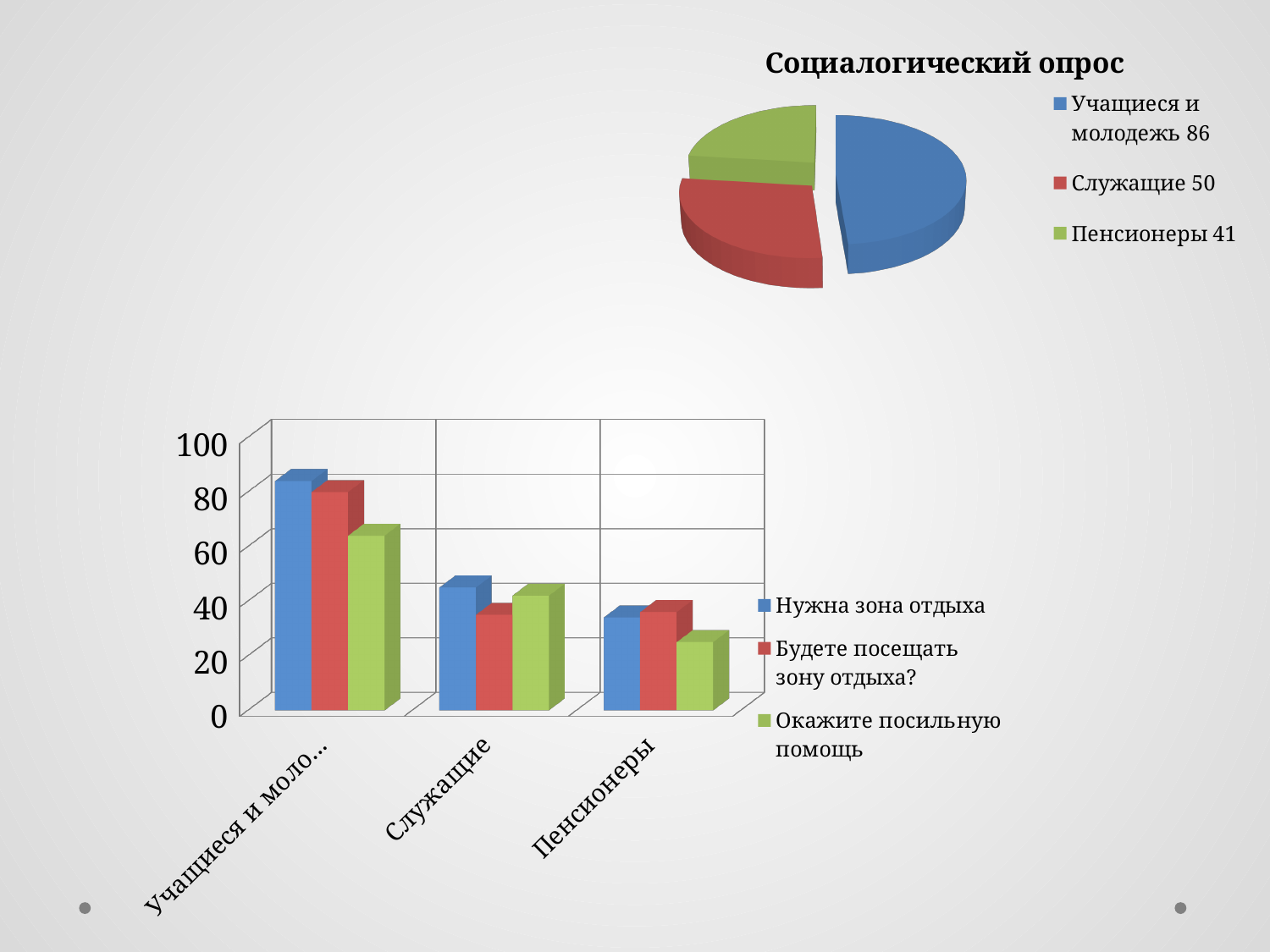
In the bar chart at the bottom of the slide, is the value of "Нужна зона отдыха" for Учащиеся и молодежь greater or less than 60? greater In the pie chart "Социалогический опрос", what number is shown for Служащие? 50 What kind of chart is the chart at the bottom of the slide? bar chart In the bar chart at the bottom of the slide, do the values of "Нужна зона отдыха" rise or fall from Учащиеся и молодежь to Пенсионеры? fall What is the title of the pie chart at the top of the slide? Социалогический опрос In the pie chart "Социалогический опрос", what number is shown for Пенсионеры? 41 In the pie chart "Социалогический опрос", what is the difference between the values for Учащиеся и молодежь and Служащие? 36 In the pie chart "Социалогический опрос", which group has the largest slice? Учащиеся и молодежь How many series does the legend of the bar chart at the bottom of the slide list? 3 How many slices does the pie chart "Социалогический опрос" have? 3 In the bar chart at the bottom of the slide, is the value of "Окажите посильную помощь" for Пенсионеры greater or less than 40? less In the pie chart "Социалогический опрос", which group has the smallest slice? Пенсионеры